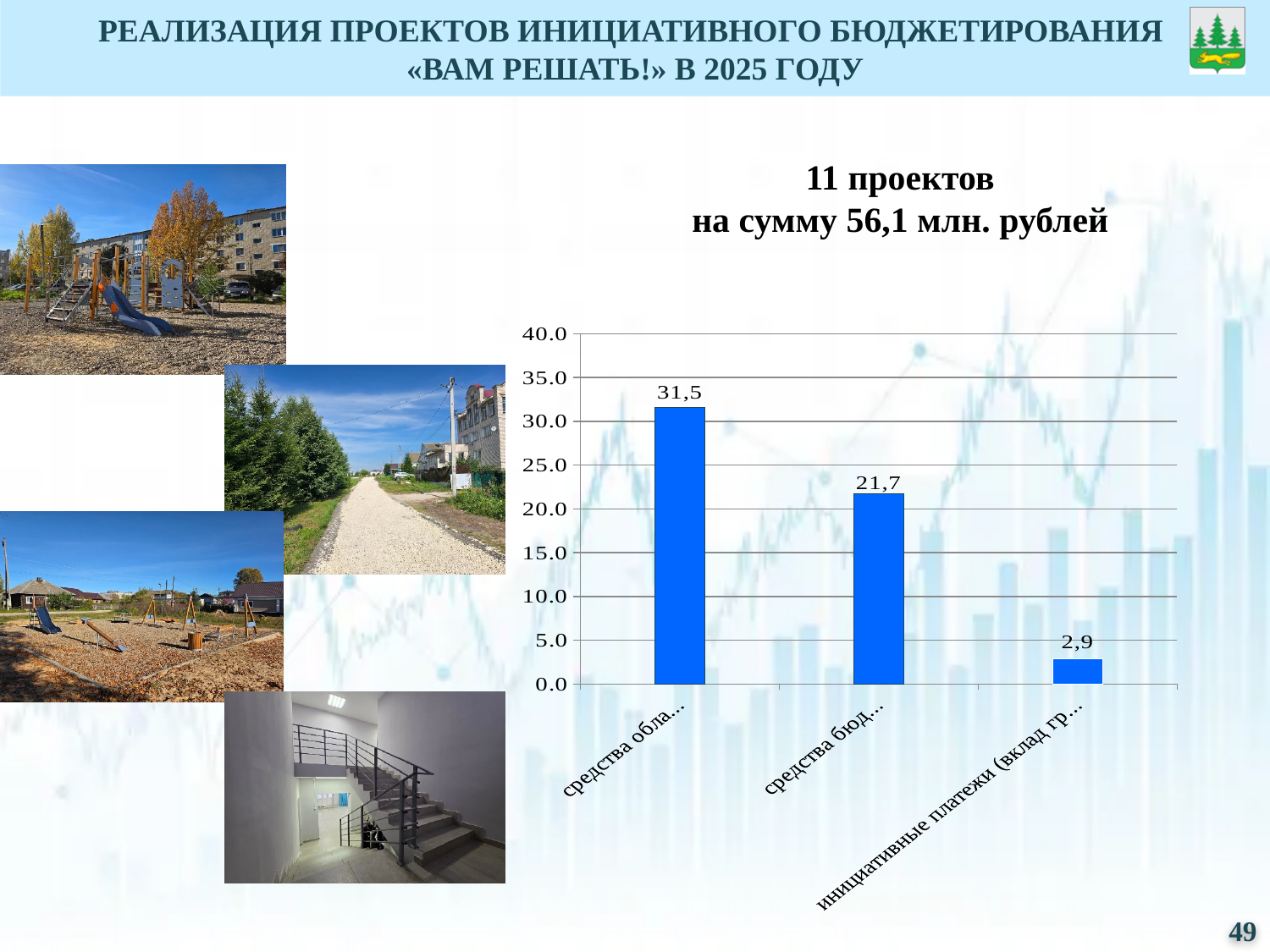
What type of chart is shown on the slide? bar chart Which is larger: the value of the second bar (средства бюд...) or the third bar (инициативные платежи)? the second bar (средства бюд...) What is the value of the second bar, labelled "средства бюд..."? 21,7 Do the bar values rise or fall from left to right along the x axis? fall How many bars does the chart show? 3 What is the difference between the first bar (31,5) and the second bar (21,7)? 9,8 Which bar has the highest value? the first bar (средства обла...) What is the value of the first (leftmost) bar, labelled "средства обла..."? 31,5 What is the difference between the second bar (21,7) and the third bar (2,9)? 18,8 What is the value of the third bar, labelled "инициативные платежи (вклад гр..."? 2,9 What is the maximum value shown on the chart's vertical axis? 40.0 Which bar has the lowest value? the third bar (инициативные платежи)